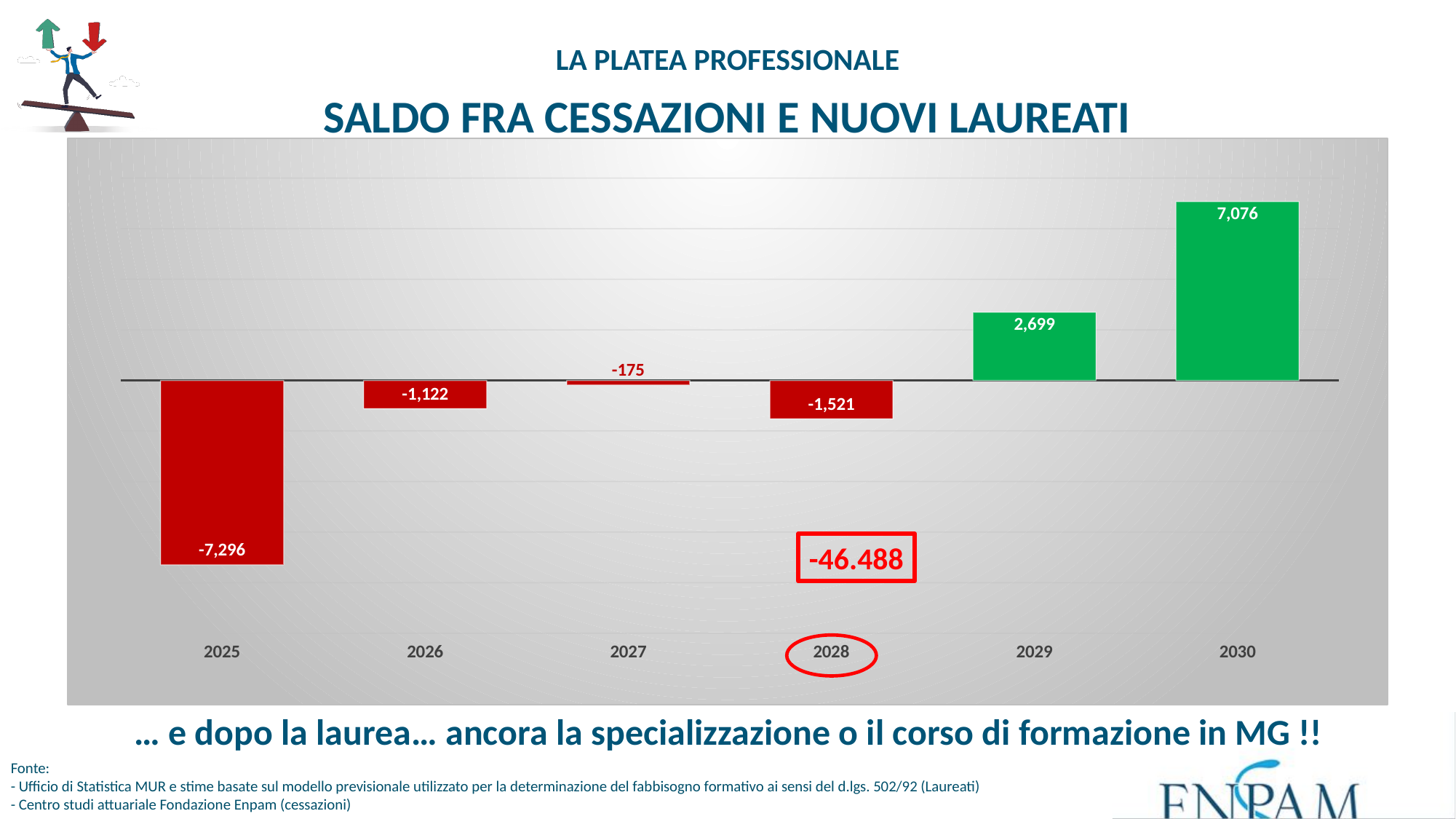
Which is larger, the value for 2026 or the value for 2028? 2026 What is the difference between the values for 2030 and 2029? 4,377 Do the values generally rise or fall from 2028 to 2030? Rise What is the value for 2025? -7,296 What kind of chart is shown? Bar chart How many years are shown on the x axis? 6 What is the value for 2027? -175 What is the title of the chart? SALDO FRA CESSAZIONI E NUOVI LAUREATI What is the value for 2030? 7,076 What is the value for 2028? -1,521 Which year has the highest value? 2030 Which year has the lowest value? 2025